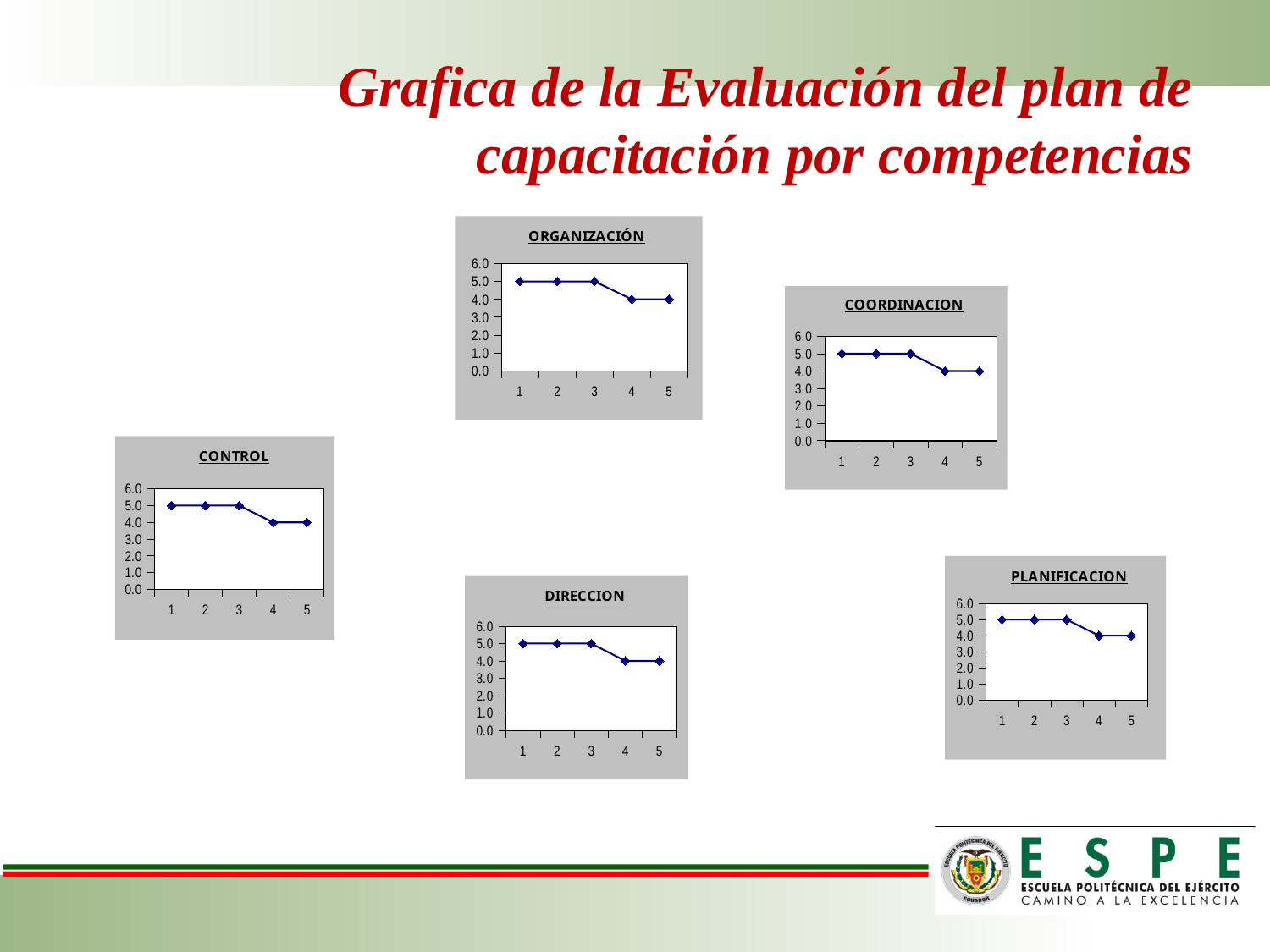
In the PLANIFICACION chart, do the values rise or fall from point 1 to point 5? fall How many charts are shown on the slide? 5 What is the title of the chart at the bottom right of the slide? PLANIFICACION In the COORDINACION chart, what is the highest value shown on the y axis? 6.0 In the PLANIFICACION chart, what is the value at point 3? 5.0 In the CONTROL chart, what is the difference between the value at point 1 and the value at point 5? 1.0 In the CONTROL chart, how many points are plotted along the x axis? 5 In the DIRECCION chart, which is larger, the value at point 2 or the value at point 4? point 2 In the DIRECCION chart, what is the value at point 5? 4.0 In the ORGANIZACIÓN chart, what is the value at point 1? 5.0 What kind of chart is the ORGANIZACIÓN chart? line chart In the COORDINACION chart, what is the value at point 4? 4.0